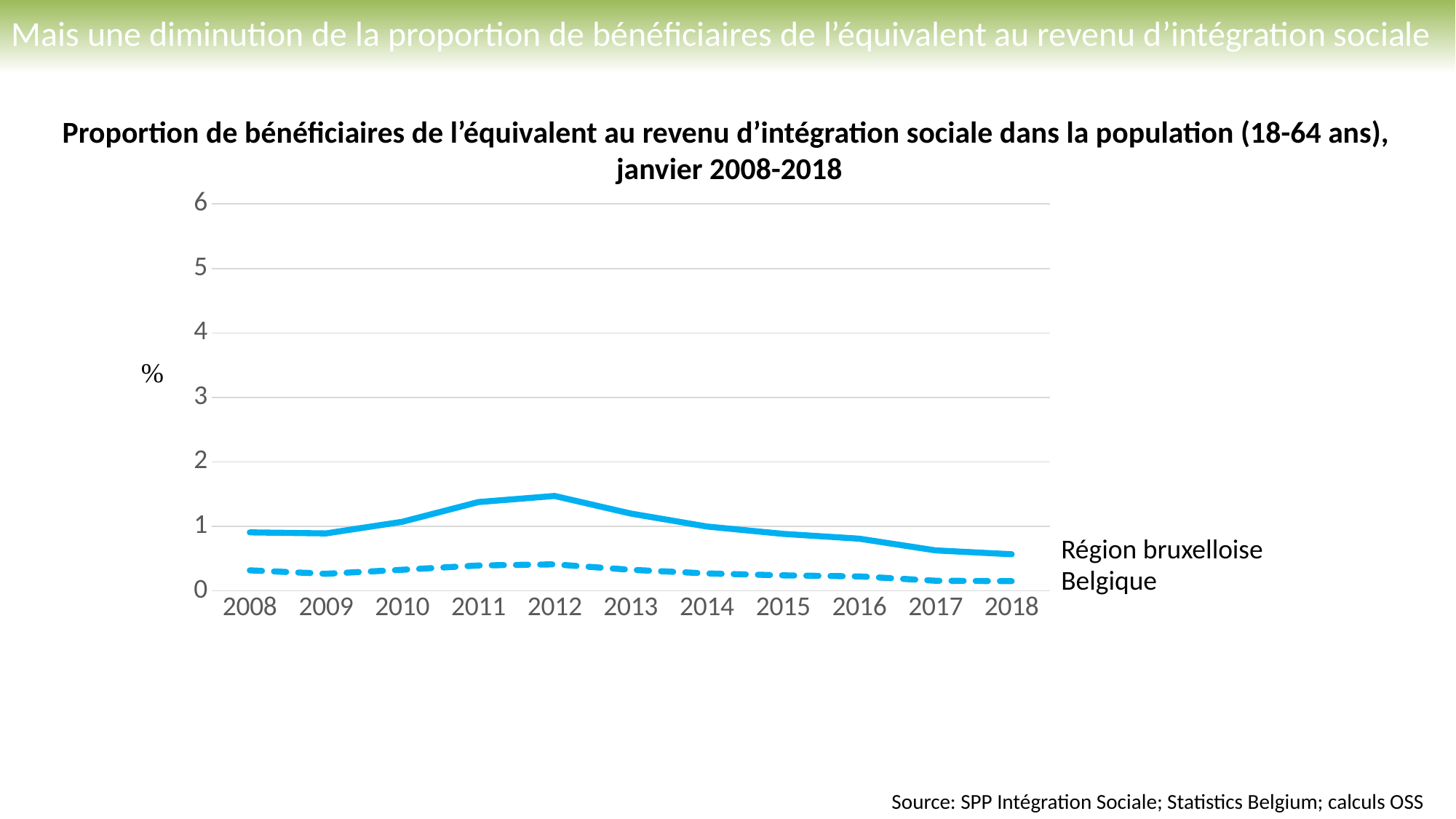
Which series has the larger value in 2012, Région bruxelloise or Belgique? Région bruxelloise Is the value for Belgique in 2012 greater or less than 1? less How many years are plotted along the x axis? 11 What kind of chart is shown on the slide? line chart Does the Région bruxelloise series rise or fall between 2012 and 2018? fall In which year does the Région bruxelloise series reach its highest value? 2012 Does the Région bruxelloise series rise or fall between 2009 and 2012? rise Which series is drawn with a dashed line? Belgique Is the value for Région bruxelloise in 2018 greater or less than 1? less What unit is shown on the y axis of the chart? % Is the value for Région bruxelloise in 2012 greater or less than 1? greater How many series does the chart show? 2